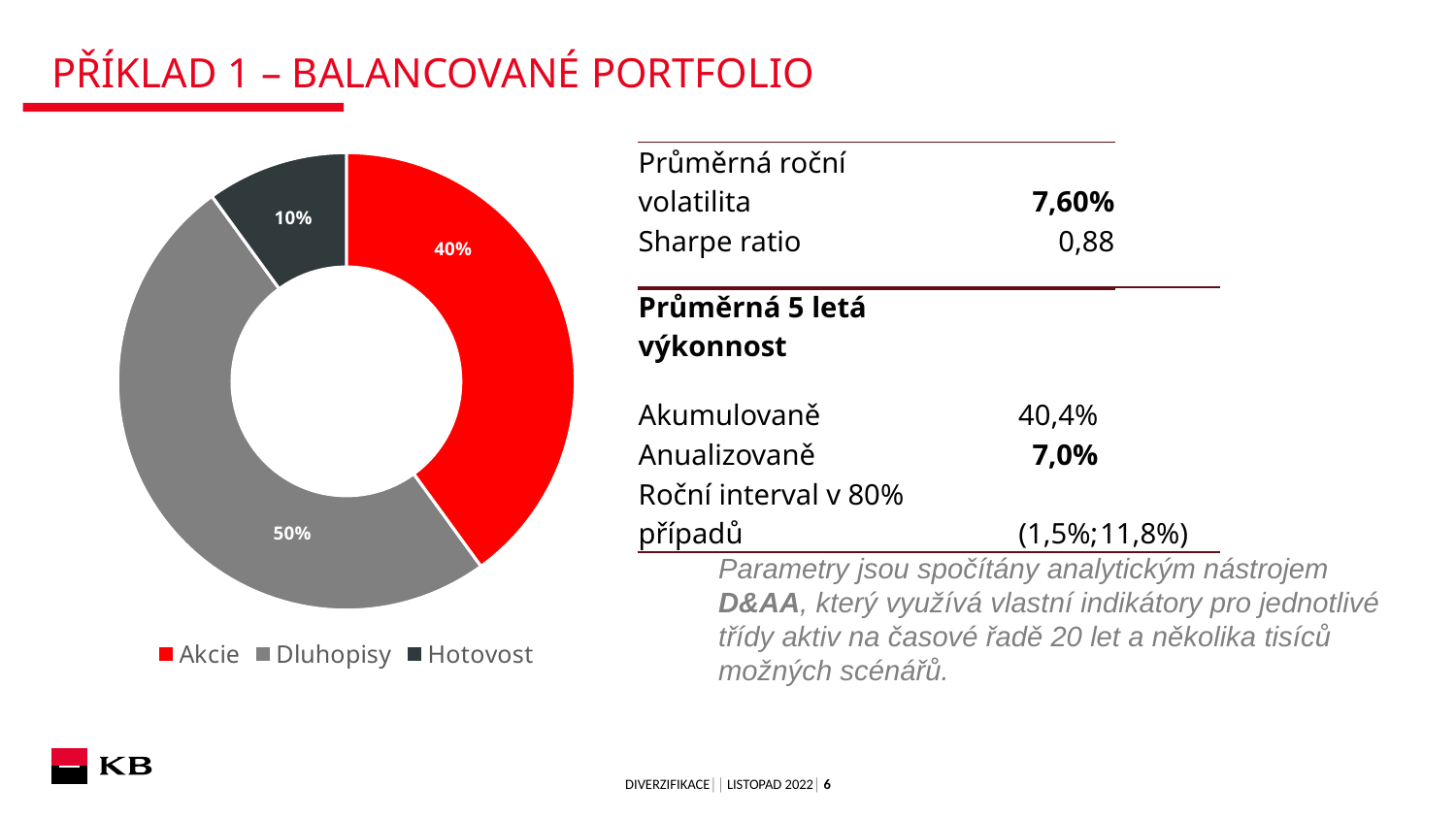
What are the three legend entries of the chart? Akcie, Dluhopisy, Hotovost What share of the portfolio is Dluhopisy? 50% Which category has the largest share of the portfolio? Dluhopisy What share of the portfolio is Hotovost? 10% What share of the portfolio is Akcie? 40% What is the difference between the Dluhopisy share and the Akcie share? 10% How many categories does the chart show? 3 What kind of chart is shown on the slide? Pie chart (doughnut) Which colour represents Akcie in the chart? Red Which category has the smallest share of the portfolio? Hotovost What is the combined share of Akcie and Dluhopisy? 90% Which is larger, the share of Akcie or the share of Hotovost? Akcie